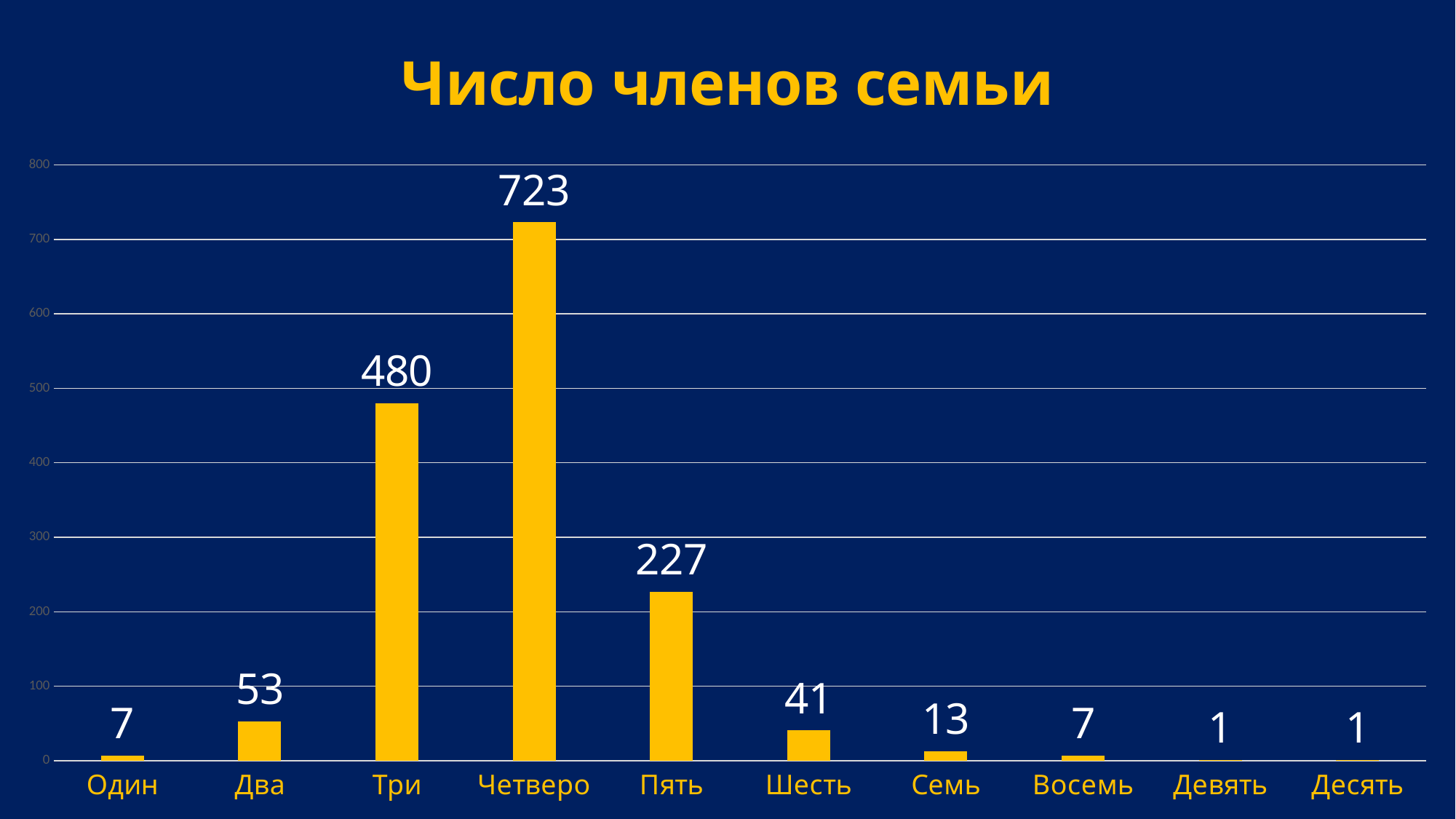
What is the value for Пять? 227 What kind of chart is shown on the slide? bar chart What is the value for Четверо? 723 What is the difference between the values for Четверо and Три? 243 Is the value for Три greater or less than 400? greater What is the value for Шесть? 41 What is the difference between the values for Пять and Два? 174 Which category has the highest value? Четверо What is the title of the chart? Число членов семьи What is the value for Три? 480 How many categories are shown on the x axis? 10 Which is larger, the value for Два or the value for Шесть? Два